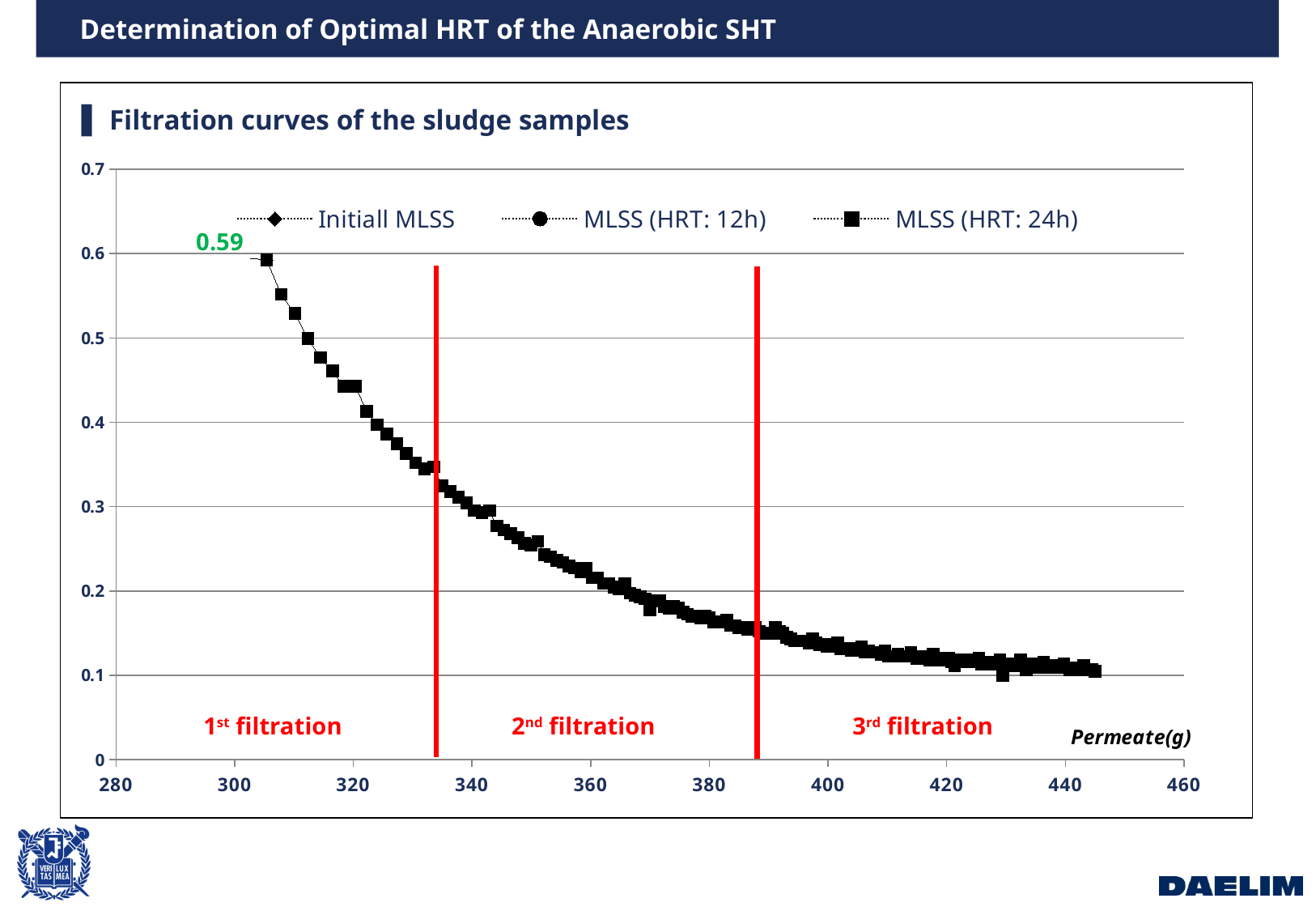
What is the labelled value at the start of the MLSS (HRT: 24h) curve? 0.59 What is the title of the chart? Filtration curves of the sludge samples Is the plotted value at a permeate of 440 g greater or less than 0.2? less Which is larger, the plotted value at a permeate of 320 g or at 400 g? 320 g What is the label of the x axis? Permeate(g) Do the plotted values rise or fall as Permeate(g) increases? fall What is the highest plotted value on the chart? 0.59 Is the plotted value at a permeate of 320 g greater or less than 0.4? greater What type of chart is shown on the slide? line chart Is the plotted value at a permeate of 400 g greater or less than 0.2? less How many series does the legend list? 3